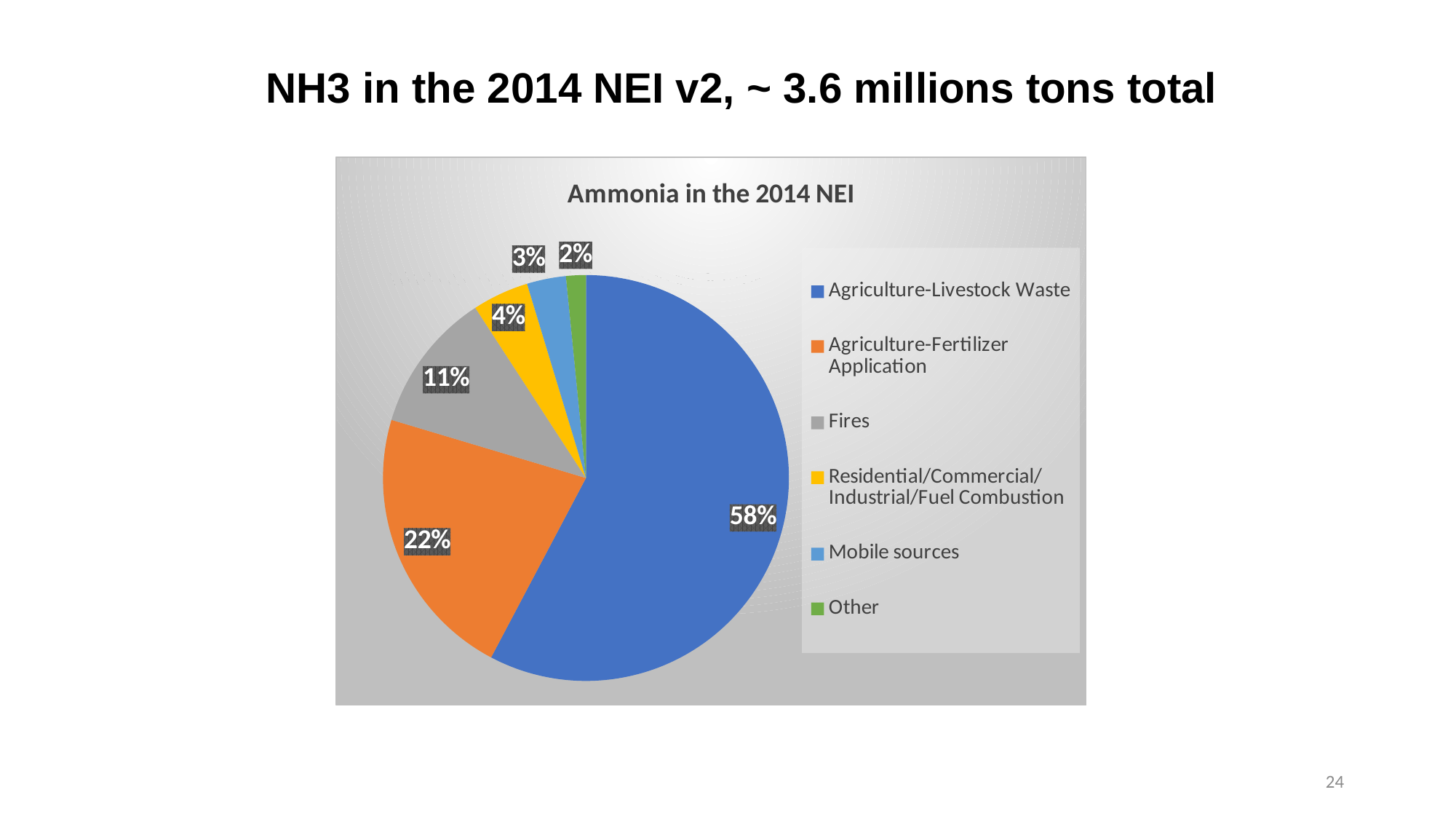
What percentage is shown for Other? 2% What is the difference in percentage points between Agriculture-Livestock Waste and Agriculture-Fertilizer Application? 36 What percentage is shown for Mobile sources? 3% Which category has the smallest share of the pie? Other How many categories does the legend list? 6 Which category has the largest share of the pie? Agriculture-Livestock Waste What share of the pie does Agriculture-Fertilizer Application account for? 22% What percentage is shown for Residential/Commercial/Industrial/Fuel Combustion? 4% What share of the pie does Agriculture-Livestock Waste account for? 58% What type of chart is shown on the slide? pie chart What is the title of the chart? Ammonia in the 2014 NEI What percentage is shown for Fires? 11%